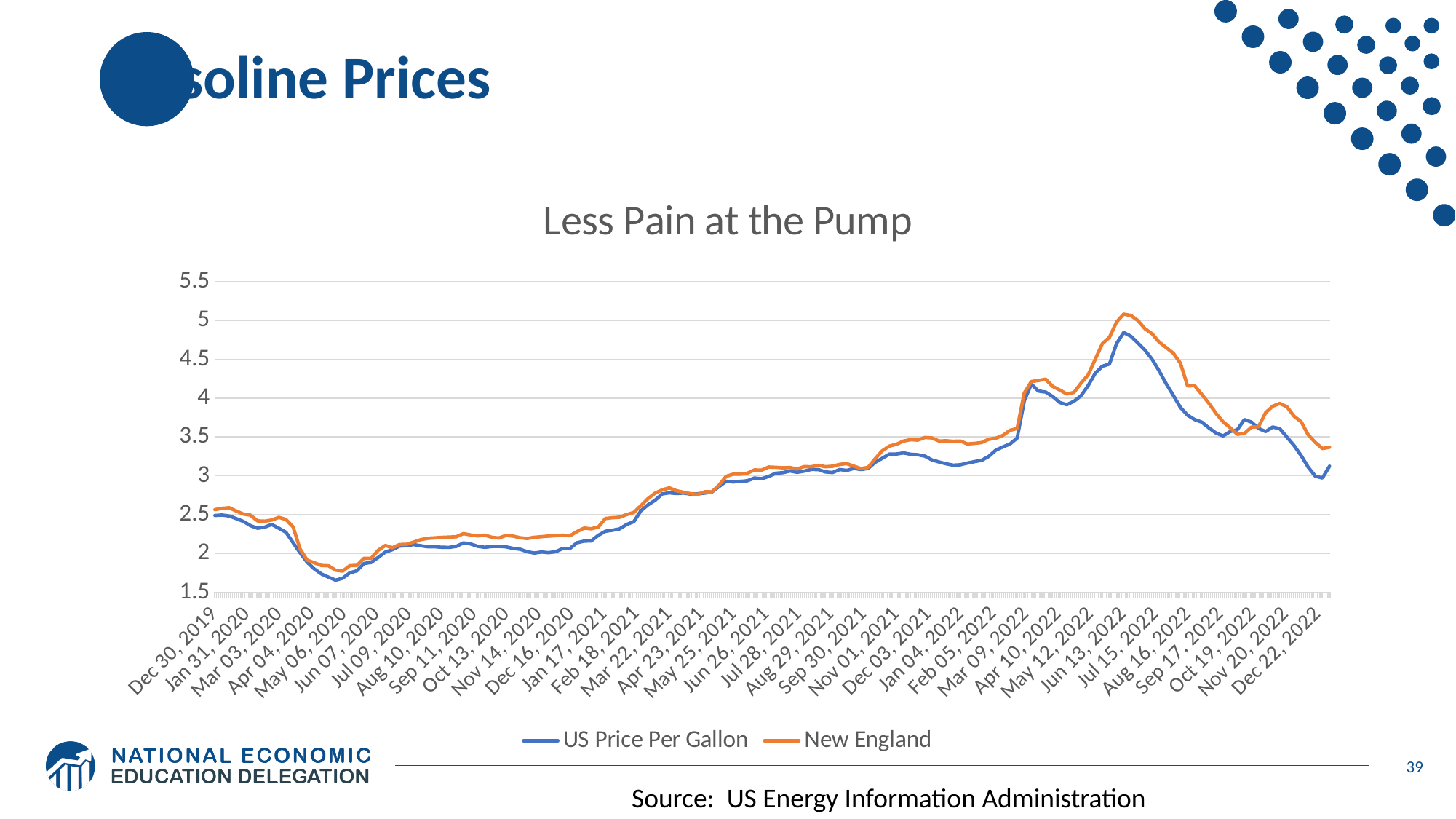
Which series is drawn in orange? New England Does the New England price rise or fall between Jul 15, 2022 and Dec 22, 2022? fall Is the US Price Per Gallon value around May 06, 2020 greater or less than 2? less Is the New England value at Dec 22, 2022 greater or less than 3? greater How many series does the chart legend list? 2 Around Jul 15, 2022, which series has the higher value, US Price Per Gallon or New England? New England Is the New England value around Jul 15, 2022 greater or less than 4.5? greater At Dec 22, 2022, which series has the higher value, US Price Per Gallon or New England? New England What is the title of the chart? Less Pain at the Pump Does the US Price Per Gallon rise or fall between Dec 30, 2019 and May 06, 2020? fall What kind of chart is shown on the slide? Line chart